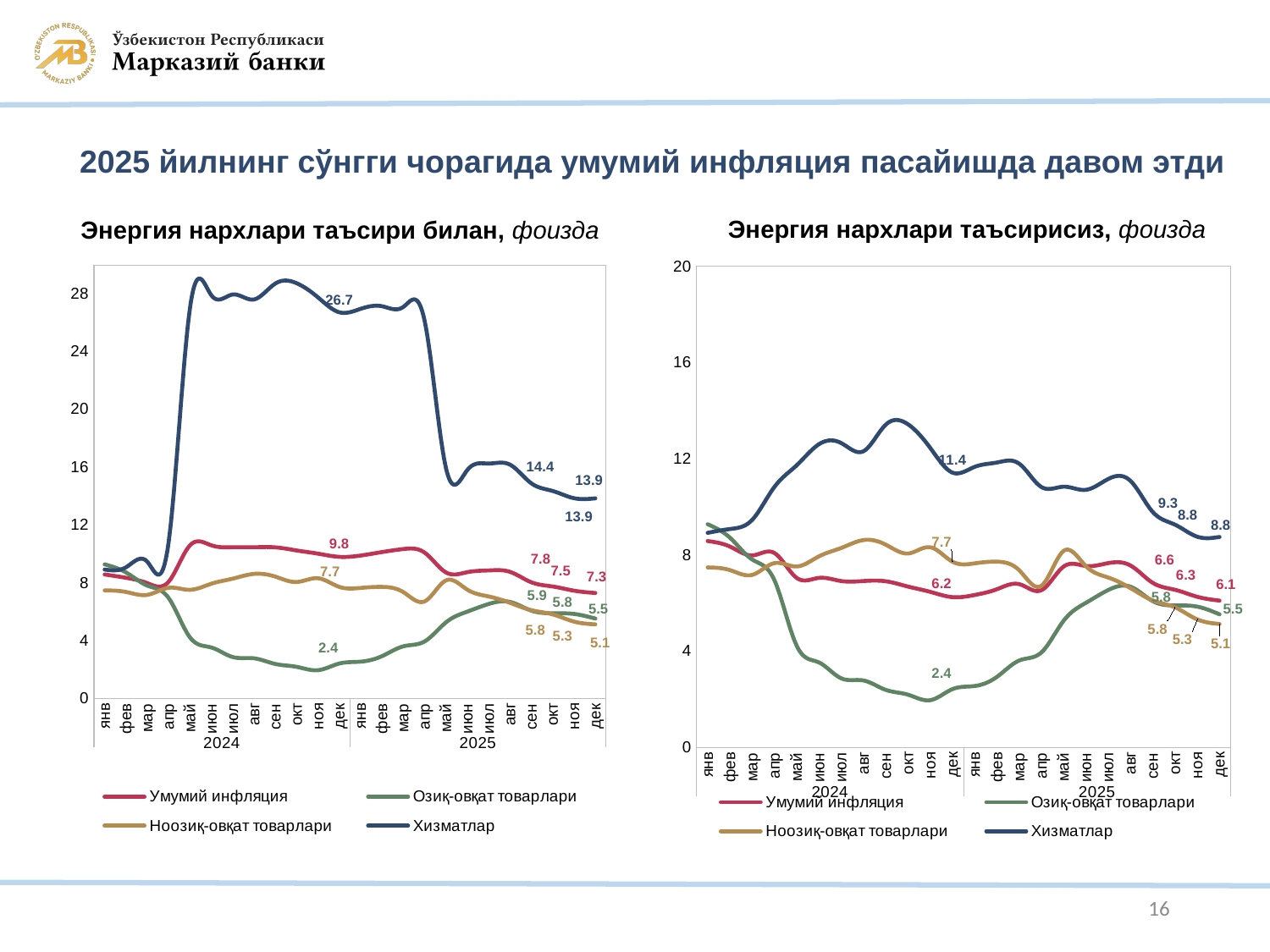
On the right chart (Энергия нархлари таъсирисиз), is the peak value of the Хизматлар line in 2024 greater or less than 12? greater What type of chart is used on the right side of the slide (Энергия нархлари таъсирисиз)? Line chart On the left chart (Энергия нархлари таъсири билан), what value is labelled for Хизматлар at the end of 2024? 26.7 On the left chart (Энергия нархлари таъсири билан), what value is labelled for Озиқ-овқат товарлари at the end of 2024? 2.4 On the left chart (Энергия нархлари таъсири билан), is the peak value of the Хизматлар line in 2024 greater or less than 28? greater On the right chart (Энергия нархлари таъсирисиз), what is the difference between the Хизматлар labels 11.4 (end of 2024) and 8.8 (end of 2025)? 2.6 On the right chart (Энергия нархлари таъсирисиз), what value is labelled for Хизматлар at the end of 2024? 11.4 How many series does the legend of the left chart list? 4 On the left chart (Энергия нархлари таъсири билан), by how much did the labelled Хизматлар value fall from 26.7 at the end of 2024 to 13.9 at the end of 2025? 12.8 On the left chart (Энергия нархлари таъсири билан), which is larger at the end of 2024: Умумий инфляция (9.8) or Ноозиқ-овқат товарлари (7.7)? Умумий инфляция On the right chart (Энергия нархлари таъсирисиз), what is the final labelled value for Умумий инфляция at the end of 2025? 6.1 On the left chart (Энергия нархлари таъсири билан), what is the final labelled value for Умумий инфляция at the end of 2025? 7.3